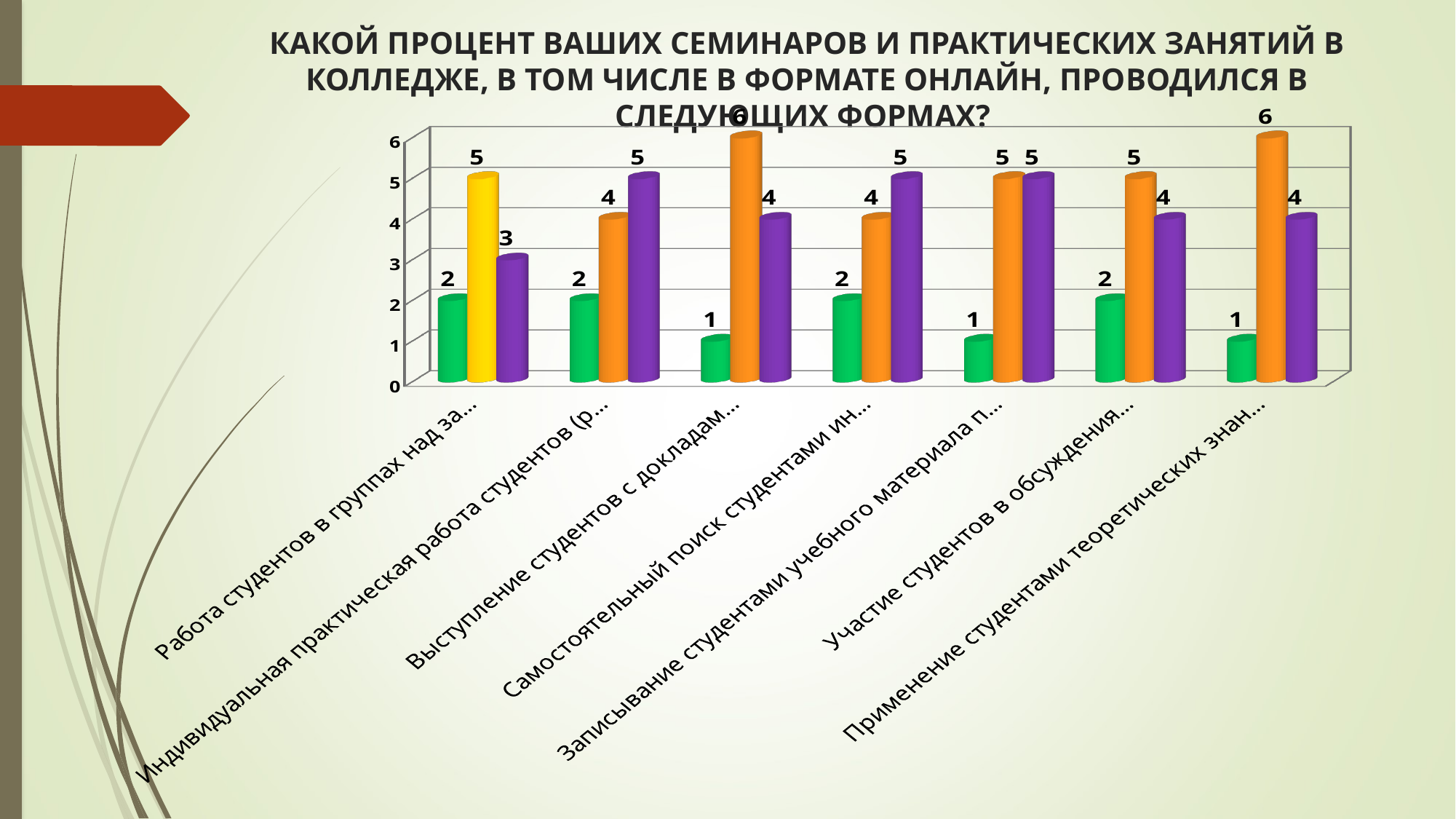
What is the value of the green (first) bar for the category "Работа студентов в группах над за..."? 2 How many categories are shown along the x axis of the chart? 7 What kind of chart is shown on the slide? bar chart What is the value of the purple (third) bar for the category "Индивидуальная практическая работа студентов (р..."? 5 How many bars are plotted for each category in the chart? 3 What is the value of the green (first) bar for the category "Применение студентами теоретических знан..."? 1 What is the difference between the orange (middle) bar and the green (first) bar for the category "Выступление студентов с докладам..."? 5 What is the highest value shown on the vertical axis of the chart? 6 What is the value of the purple (third) bar for the category "Работа студентов в группах над за..."? 3 What is the value of the orange (middle) bar for the category "Выступление студентов с докладам..."? 6 For the category "Участие студентов в обсуждения...", which is larger: the orange (middle) bar or the purple (third) bar? the orange (middle) bar Which category has the lowest value for the purple (third) bar? Работа студентов в группах над за...